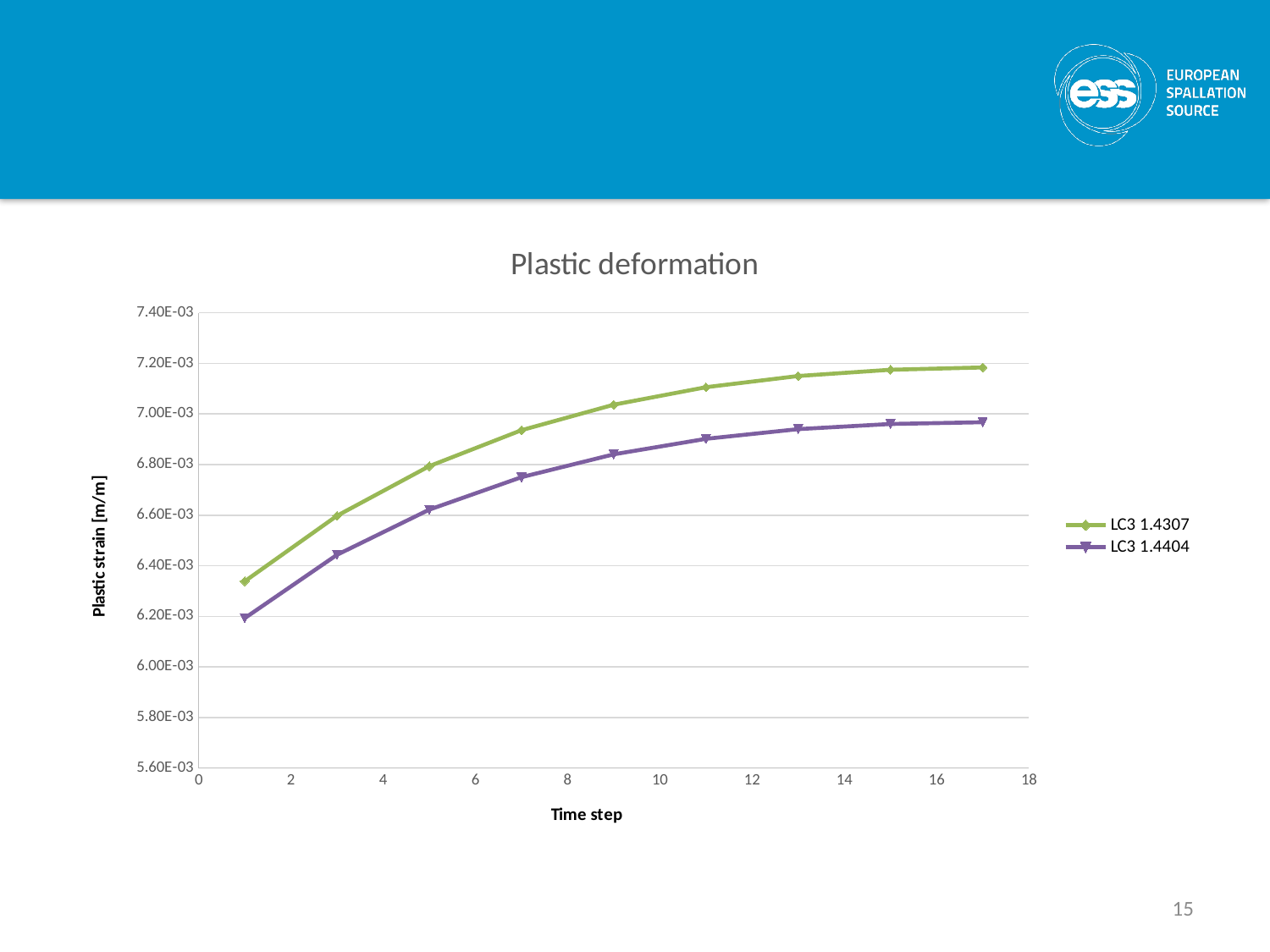
Is the value for LC3 1.4404 at time step 11 greater or less than 6.80E-03? greater What kind of chart is shown on the slide? Line chart Do the values for LC3 1.4404 rise or fall as the time step increases? Rise What is the title of the chart? Plastic deformation Which series has the lower plastic strain at time step 1? LC3 1.4404 How many series does the legend list? 2 Is the value for LC3 1.4404 at time step 17 greater or less than 7.00E-03? less Which series has the higher plastic strain at time step 9, LC3 1.4307 or LC3 1.4404? LC3 1.4307 What is the label of the y axis? Plastic strain [m/m] How many data points are plotted for the LC3 1.4307 series? 9 Is the value for LC3 1.4307 at time step 7 greater or less than 6.80E-03? greater